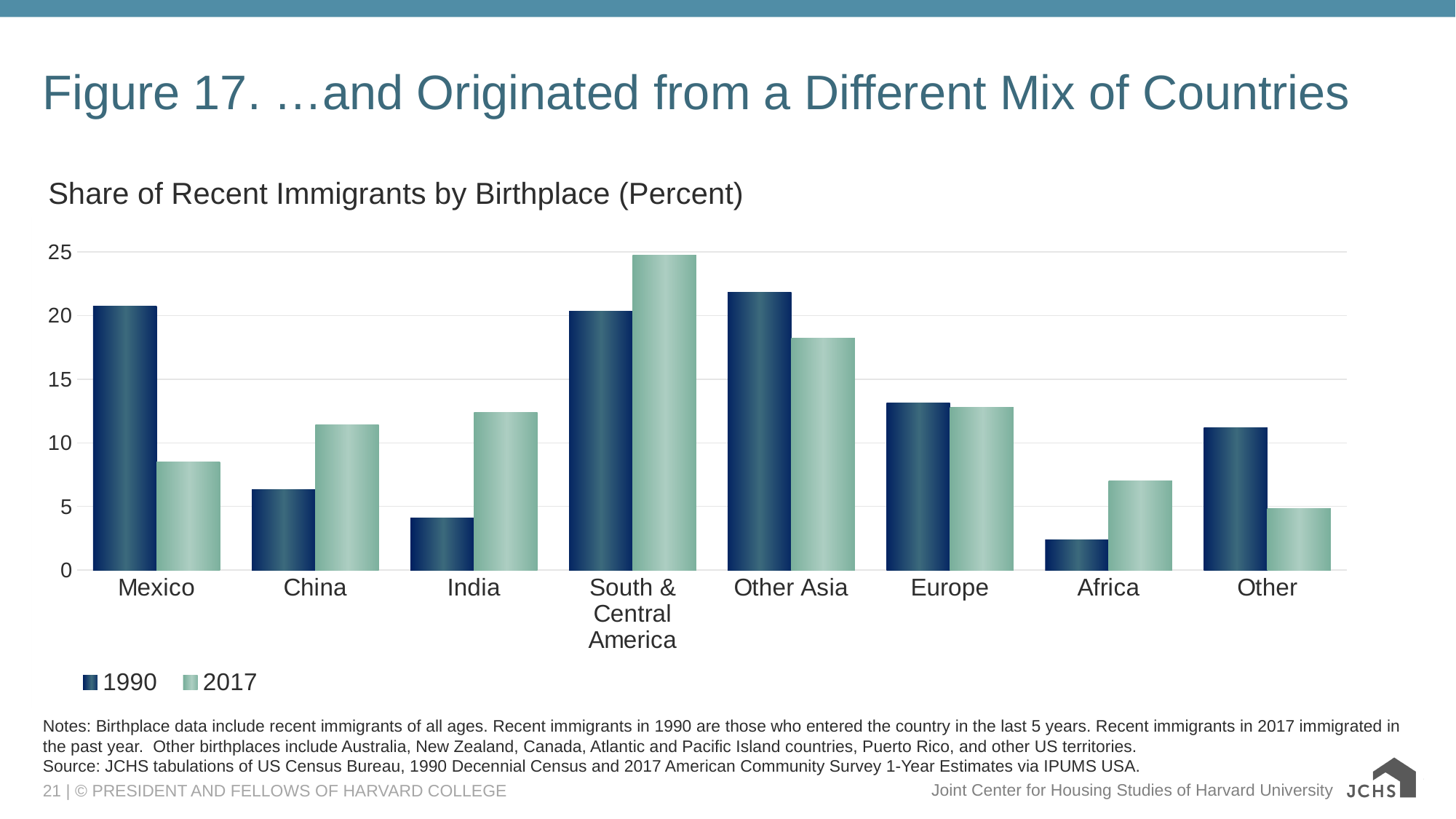
How many series does the legend list? 2 For China, which year has the larger share, 1990 or 2017? 2017 Which birthplace has the lowest share for 2017? Other Is the 2017 value for India greater or less than 10? greater How many birthplace categories are shown on the x axis? 8 Which birthplace has the highest share for 2017? South & Central America Is the 2017 value for Mexico greater or less than 10? less For Other Asia, which year has the larger share, 1990 or 2017? 1990 Which birthplace has the lowest share for 1990? Africa What kind of chart is shown on the slide? bar chart What is the subtitle describing the chart's measure? Share of Recent Immigrants by Birthplace (Percent) Is the 1990 value for Mexico greater or less than 20? greater